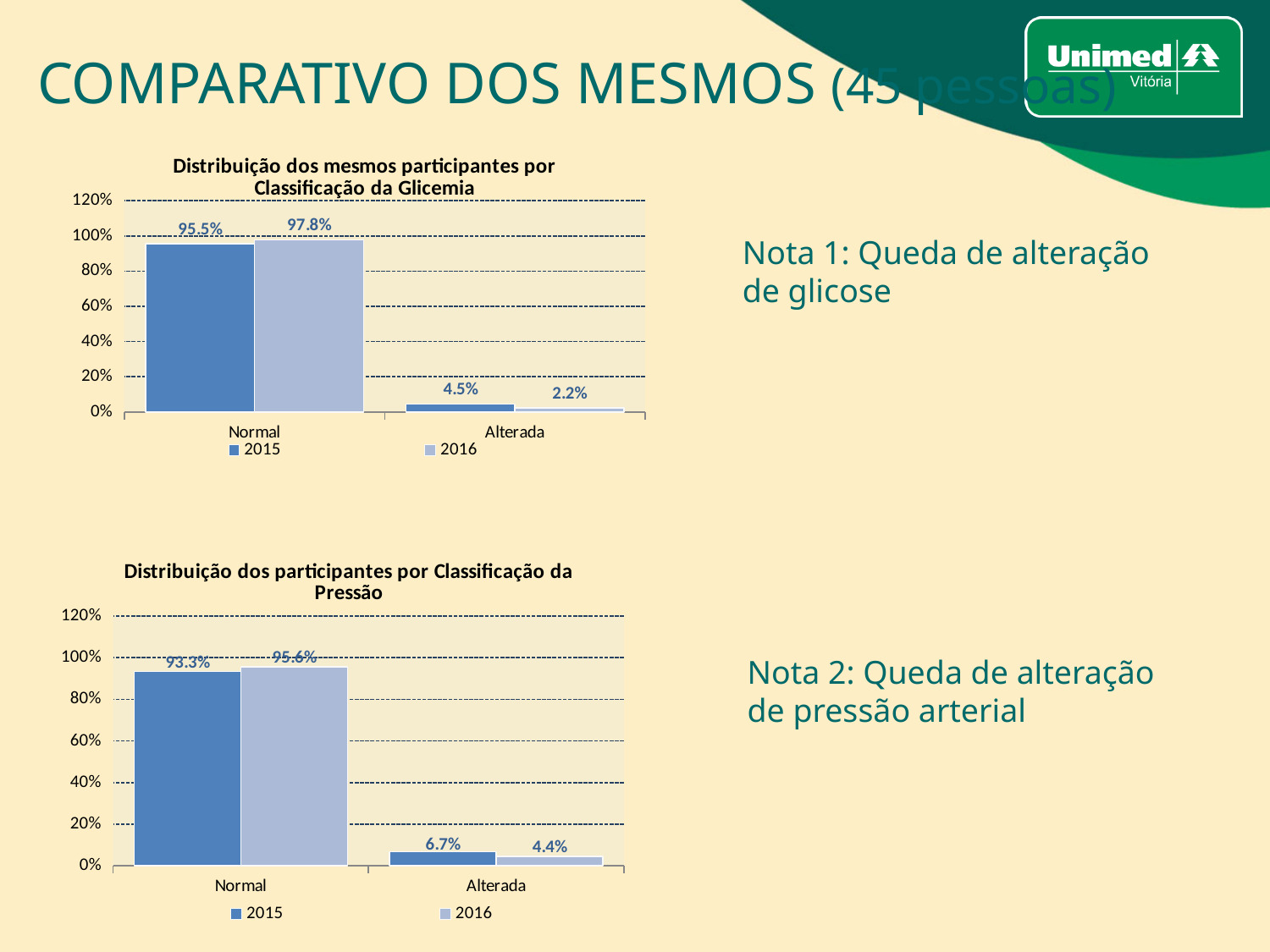
In the top chart (Classificação da Glicemia), what is the difference between the 2016 and 2015 values for Normal? 2.3% In the top chart (Classificação da Glicemia), is the value for Normal in 2016 greater or less than 80%? greater In the bottom chart (Classificação da Pressão), what is the difference between the 2015 and 2016 values for Alterada? 2.3% In the top chart (Classificação da Glicemia), which year has the larger value for Alterada, 2015 or 2016? 2015 In the top chart (Classificação da Glicemia), what is the value for Alterada in 2016? 2.2% What type of chart is the bottom chart (Classificação da Pressão)? Bar chart In the top chart (Classificação da Glicemia), what is the value for Normal in 2015? 95.5% In the top chart (Classificação da Glicemia), how many series does the legend list? 2 In the bottom chart (Classificação da Pressão), how many categories are shown on the x axis? 2 In the bottom chart (Classificação da Pressão), which bar is the lowest? Alterada 2016 (4.4%) In the bottom chart (Classificação da Pressão), what is the value for Normal in 2016? 95.6% In the bottom chart (Classificação da Pressão), what is the value for Alterada in 2015? 6.7%